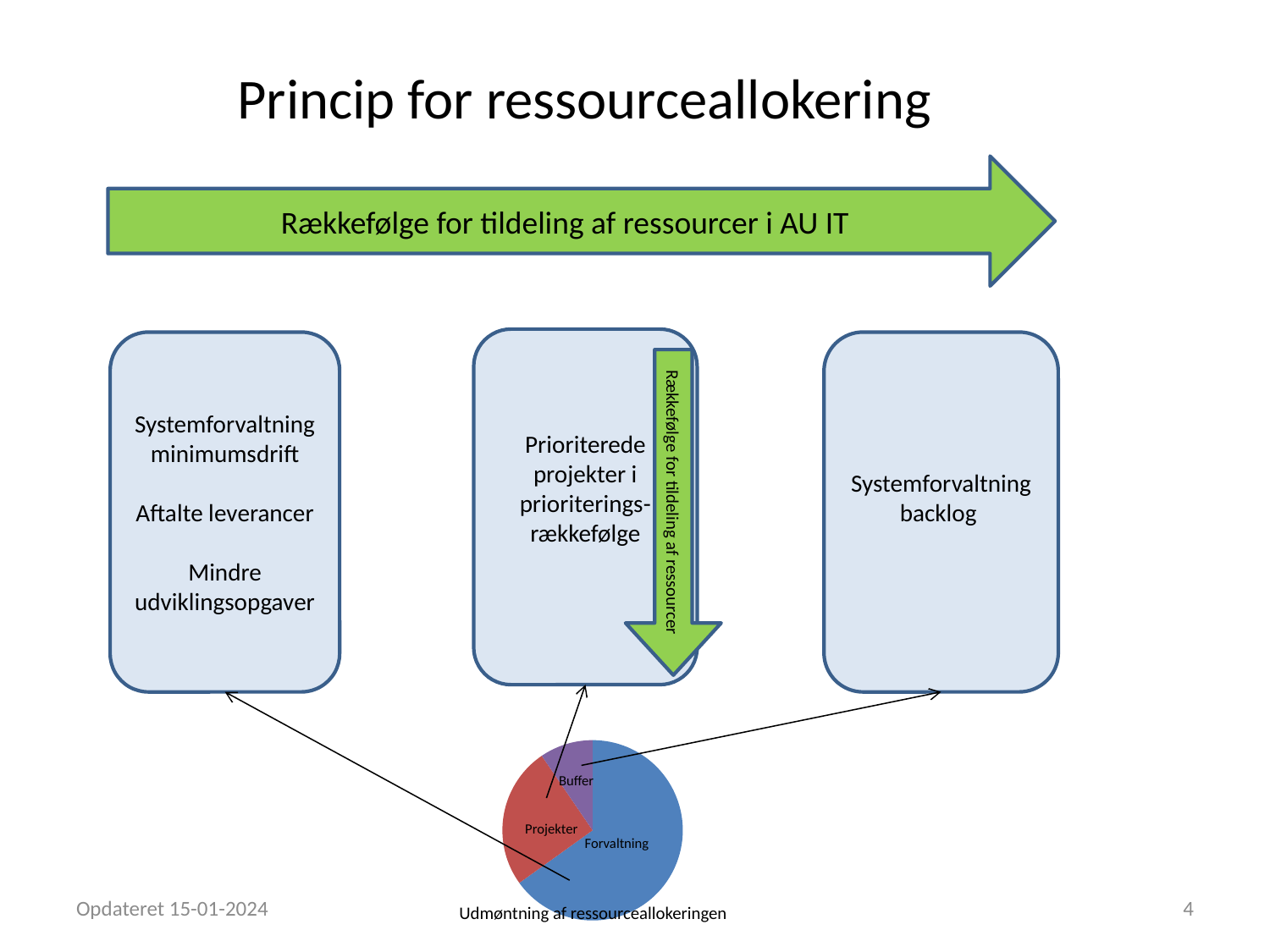
In the pie chart, which is larger: Forvaltning or Projekter? Forvaltning Which slice of the pie chart is the smallest? Buffer What kind of chart is shown at the bottom of the slide? pie chart How many slices does the pie chart have? 3 Which slice of the pie chart is the largest? Forvaltning What is the title of the pie chart? Udmøntning af ressourceallokeringen In the pie chart, which is larger: Projekter or Buffer? Projekter What colour is the Forvaltning slice in the pie chart? blue